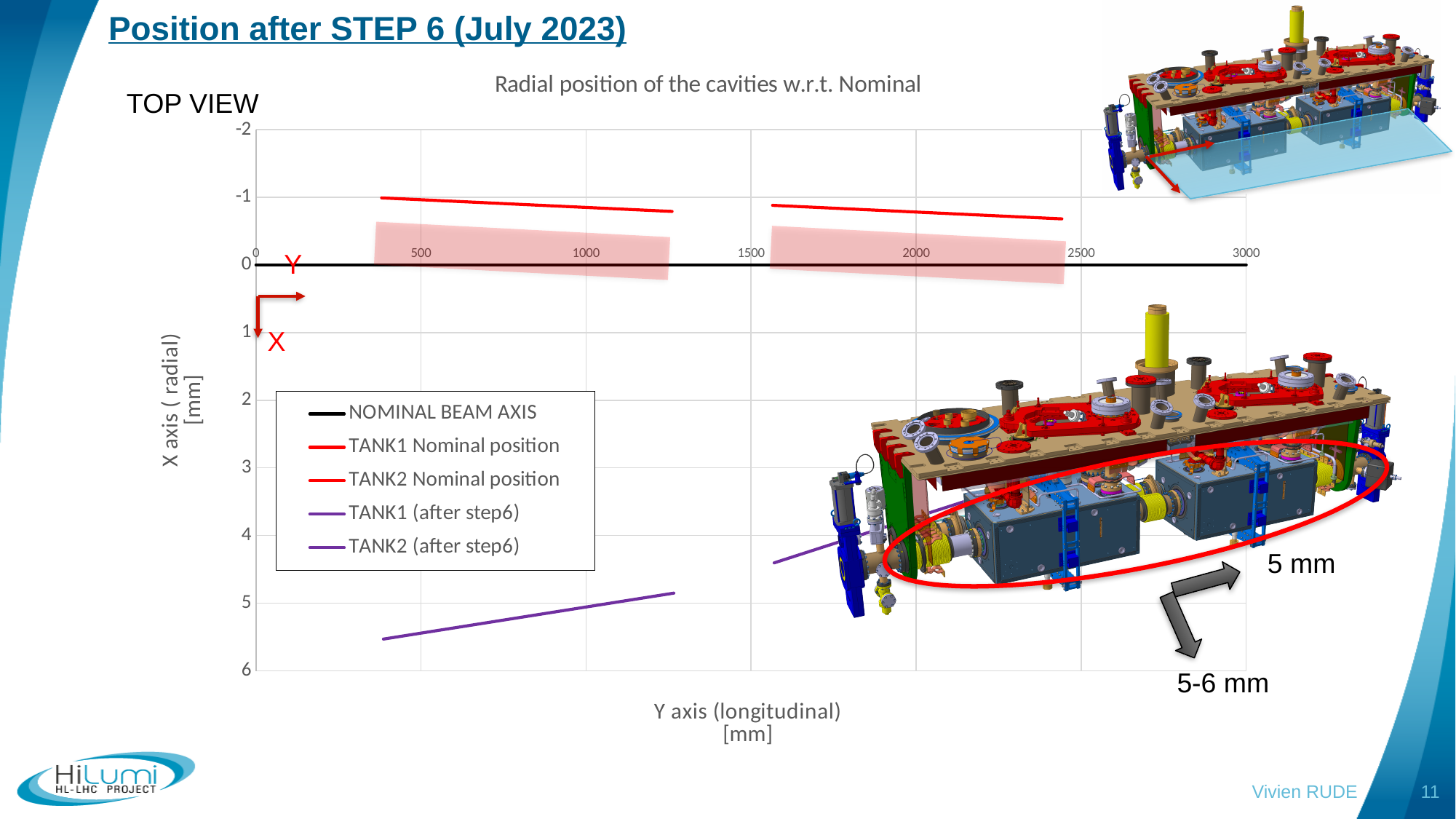
What type of chart is shown on the slide? Line chart Do the values of the TANK1 (after step6) line increase or decrease as the longitudinal Y position increases? decrease Is the value of the TANK1 (after step6) line at Y = 500 mm greater or less than 5? greater How many series does the chart legend list? 5 Is the value of the TANK2 (after step6) line at its left end (around Y = 1550 mm) greater or less than 5? less How many tick labels are shown on the horizontal (Y longitudinal) axis, from 0 to 3000? 7 What is the highest value shown on the vertical (X radial) axis? 6 Which line shows the larger radial offset from the nominal beam axis: TANK1 (after step6) or TANK2 (after step6)? TANK1 (after step6) What is the label of the horizontal axis of the chart? Y axis (longitudinal) [mm] Is the value of the TANK1 Nominal position line greater or less than 0? less What is the title of the chart? Radial position of the cavities w.r.t. Nominal